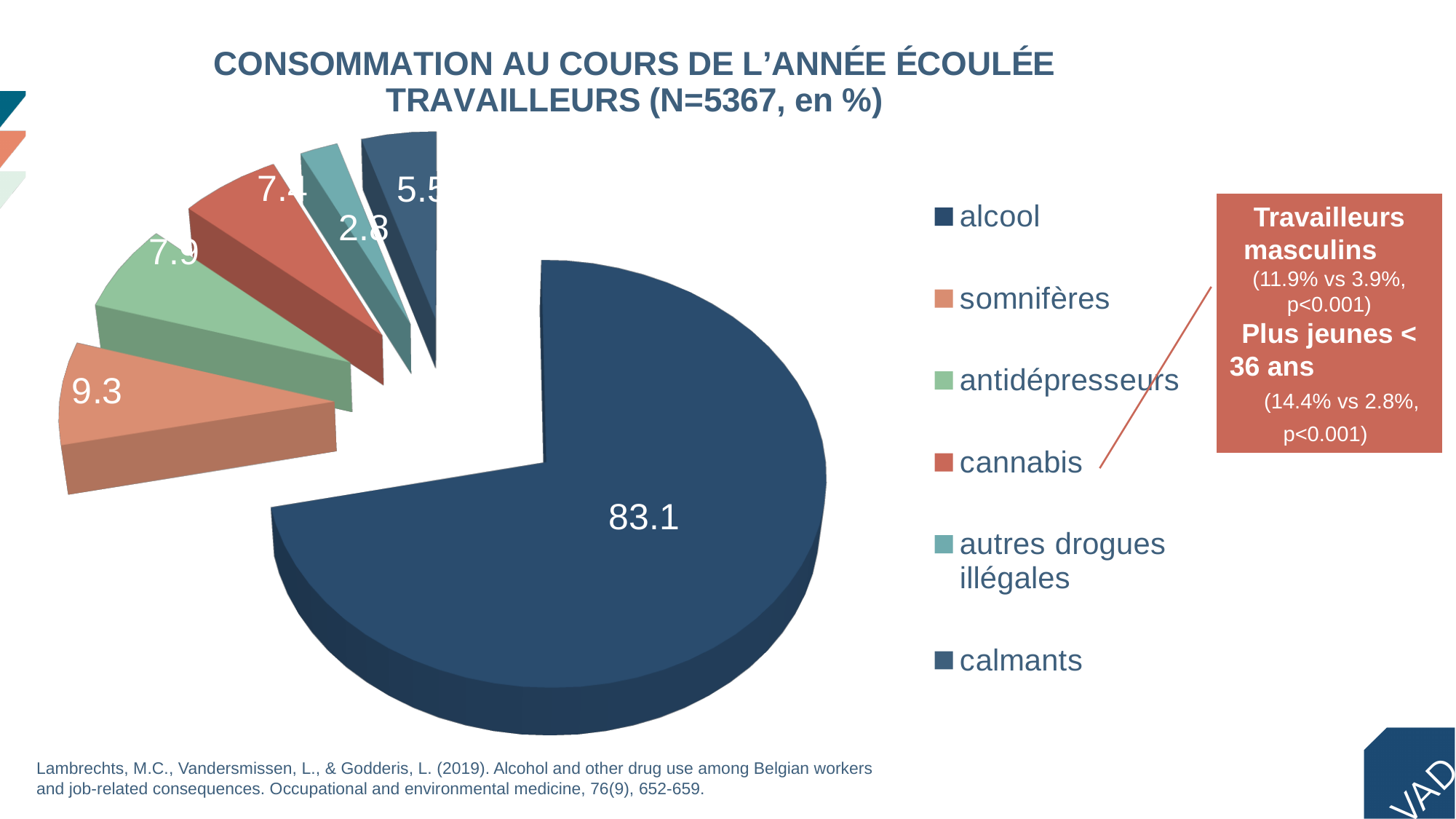
What is the value for cannabis? 7.4 What type of chart is shown on the slide? pie chart Which category has the largest slice? alcool What is the value for somnifères? 9.3 What is the value for autres drogues illégales? 2.8 Which is larger, the value for somnifères or the value for calmants? somnifères What is the difference between the values for alcool and somnifères? 73.8 How many categories does the legend list? 6 What is the value for alcool? 83.1 Which category has the smallest slice? autres drogues illégales What is the value for antidépresseurs? 7.9 What is the value for calmants? 5.5